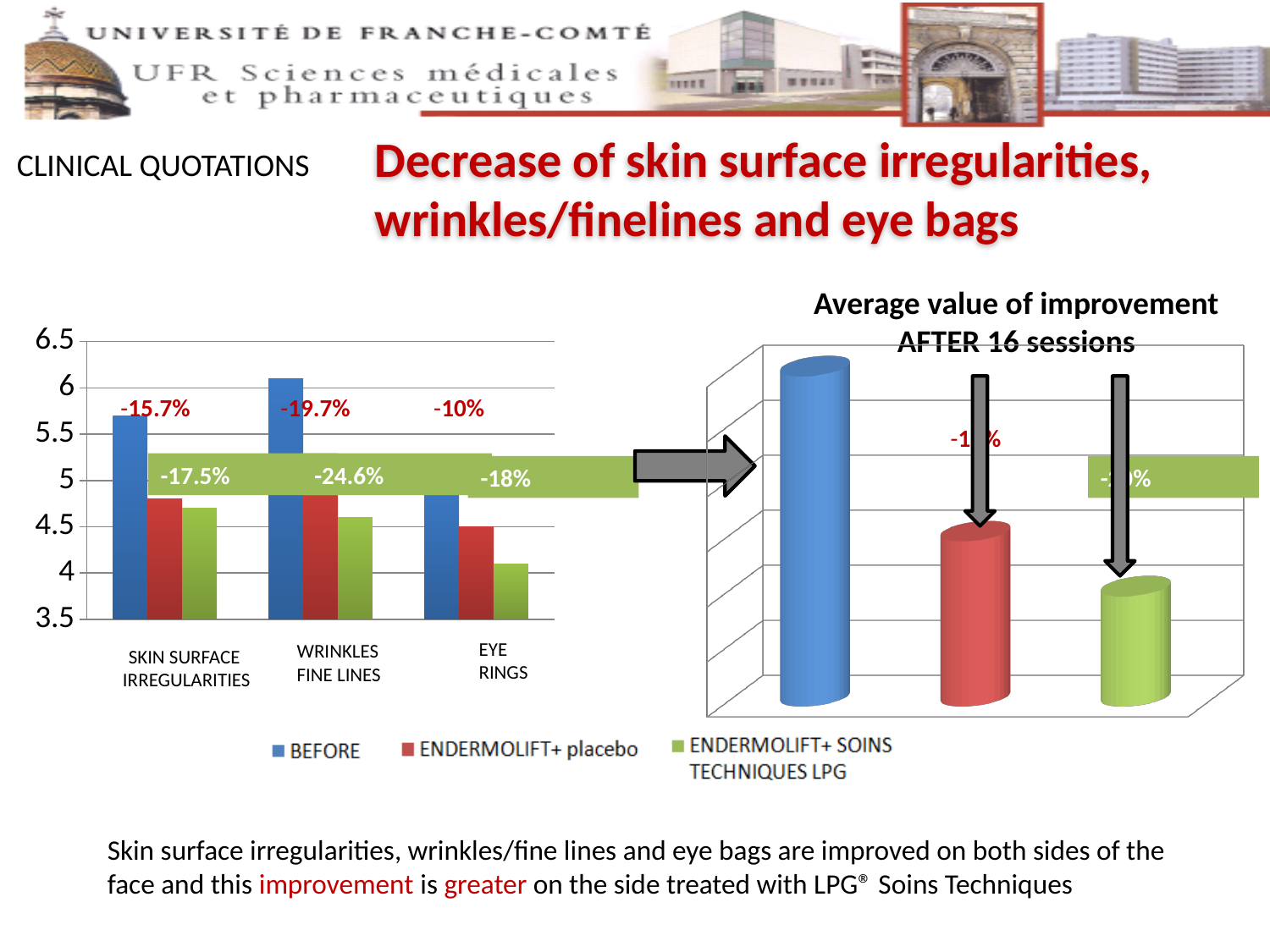
What is the title of the chart on the right? Average value of improvement AFTER 16 sessions On the left chart, what percentage change is labelled for ENDERMOLIFT+ SOINS TECHNIQUES LPG on EYE RINGS? -18% On the left chart, which is larger: the BEFORE value for SKIN SURFACE IRREGULARITIES or the BEFORE value for EYE RINGS? SKIN SURFACE IRREGULARITIES On the left chart, which category has the highest BEFORE value? WRINKLES FINE LINES On the left chart, what kind of chart is shown? bar chart On the left chart, what percentage change is labelled for ENDERMOLIFT+ placebo on EYE RINGS? -10% On the left chart, what percentage change is labelled for ENDERMOLIFT+ SOINS TECHNIQUES LPG on SKIN SURFACE IRREGULARITIES? -17.5% On the left chart, what percentage change is labelled for ENDERMOLIFT+ placebo on WRINKLES FINE LINES? -19.7% On the left chart, how many categories are shown on the x axis? 3 On the left chart, is the BEFORE value for WRINKLES FINE LINES greater or less than 6? greater On the left chart, how many series does the legend list? 3